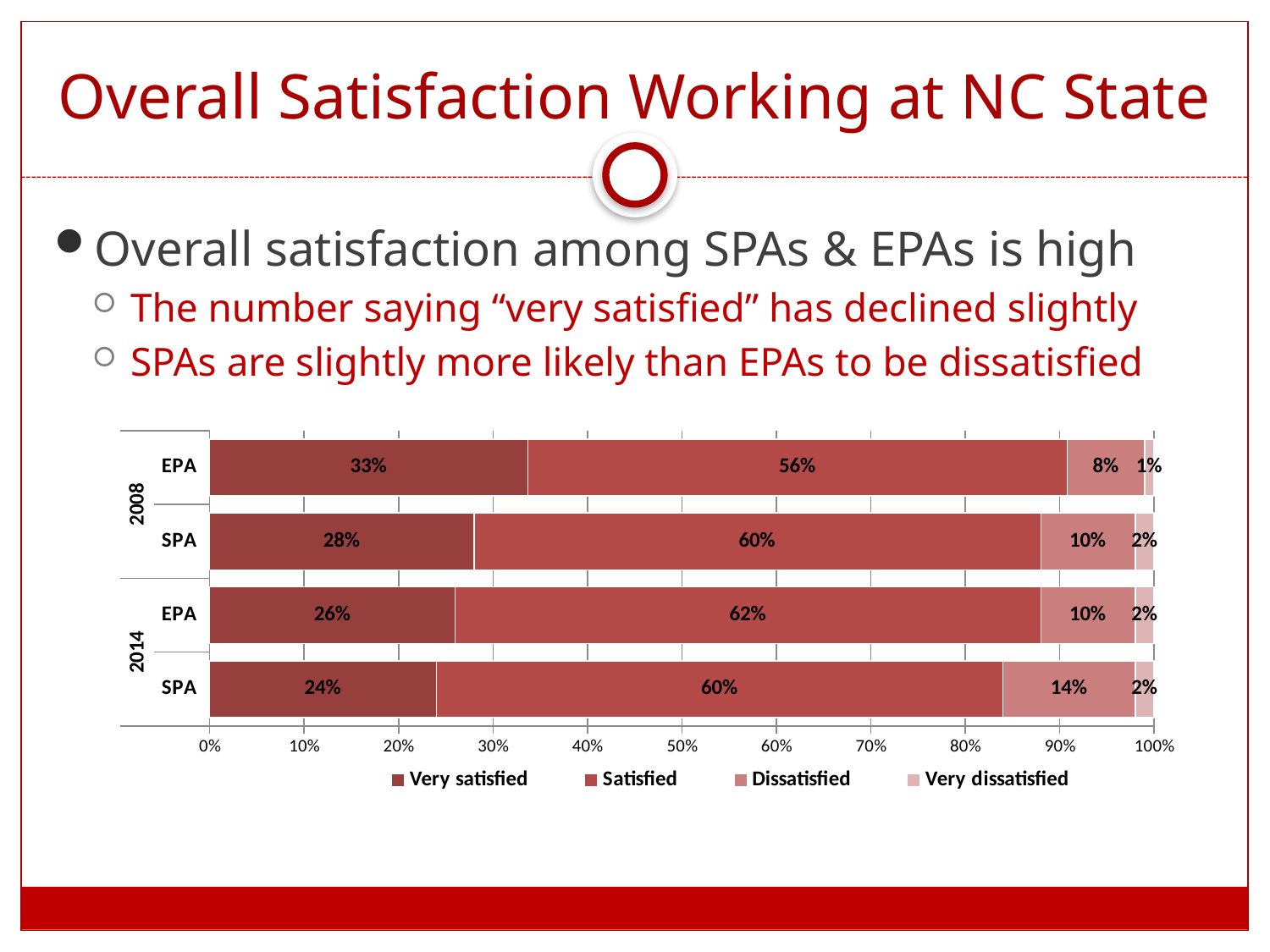
What is the combined percentage of 'Very satisfied' and 'Satisfied' for SPAs in 2014? 84% What kind of chart is shown on the slide? Stacked bar chart Which group and year has the lowest 'Very satisfied' percentage? SPA 2014 How many series does the legend list? 4 What percentage of SPAs in 2008 were very dissatisfied? 2% What percentage of SPAs in 2014 were dissatisfied? 14% How many bars are shown in the chart? 4 Which is larger: the 'Dissatisfied' percentage for SPAs in 2014 or for EPAs in 2014? SPA 2014 Which group and year has the highest 'Very satisfied' percentage? EPA 2008 What percentage of EPAs in 2014 were satisfied? 62% What percentage of EPAs in 2008 were very satisfied? 33% What is the difference between the 'Very satisfied' percentage for EPAs in 2008 and EPAs in 2014? 7%